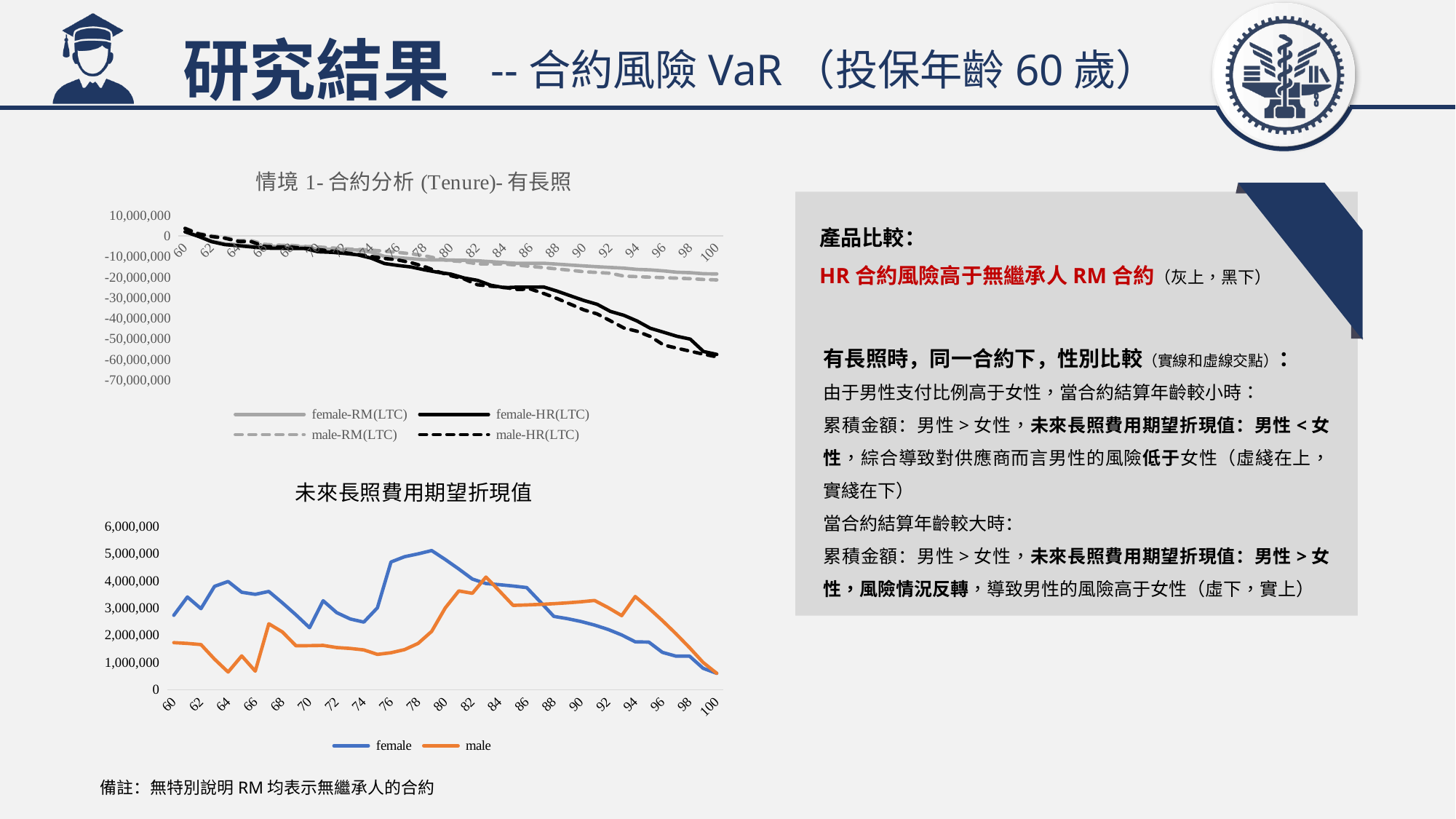
What is the title of the bottom chart on the slide? 未來長照費用期望折現值 In the top chart (情境 1- 合約分析 (Tenure)- 有長照), do the lines rise or fall as age increases along the x axis? fall In the top chart (情境 1- 合約分析 (Tenure)- 有長照), is the value for female-RM(LTC) at age 100 greater or less than -30,000,000? greater In the top chart (情境 1- 合約分析 (Tenure)- 有長照), is the value for female-HR(LTC) at age 100 greater or less than -50,000,000? less In the bottom chart (未來長照費用期望折現值), is the value for male at age 64 greater or less than 1,000,000? less In the bottom chart (未來長照費用期望折現值), which series has the higher value at age 60, female or male? female What type of chart is the top chart titled 情境 1- 合約分析 (Tenure)- 有長照? line chart How many series does the legend of the top chart (情境 1- 合約分析 (Tenure)- 有長照) list? 4 How many series does the legend of the bottom chart (未來長照費用期望折現值) list? 2 In the bottom chart (未來長照費用期望折現值), which series has the higher value at age 94, female or male? male